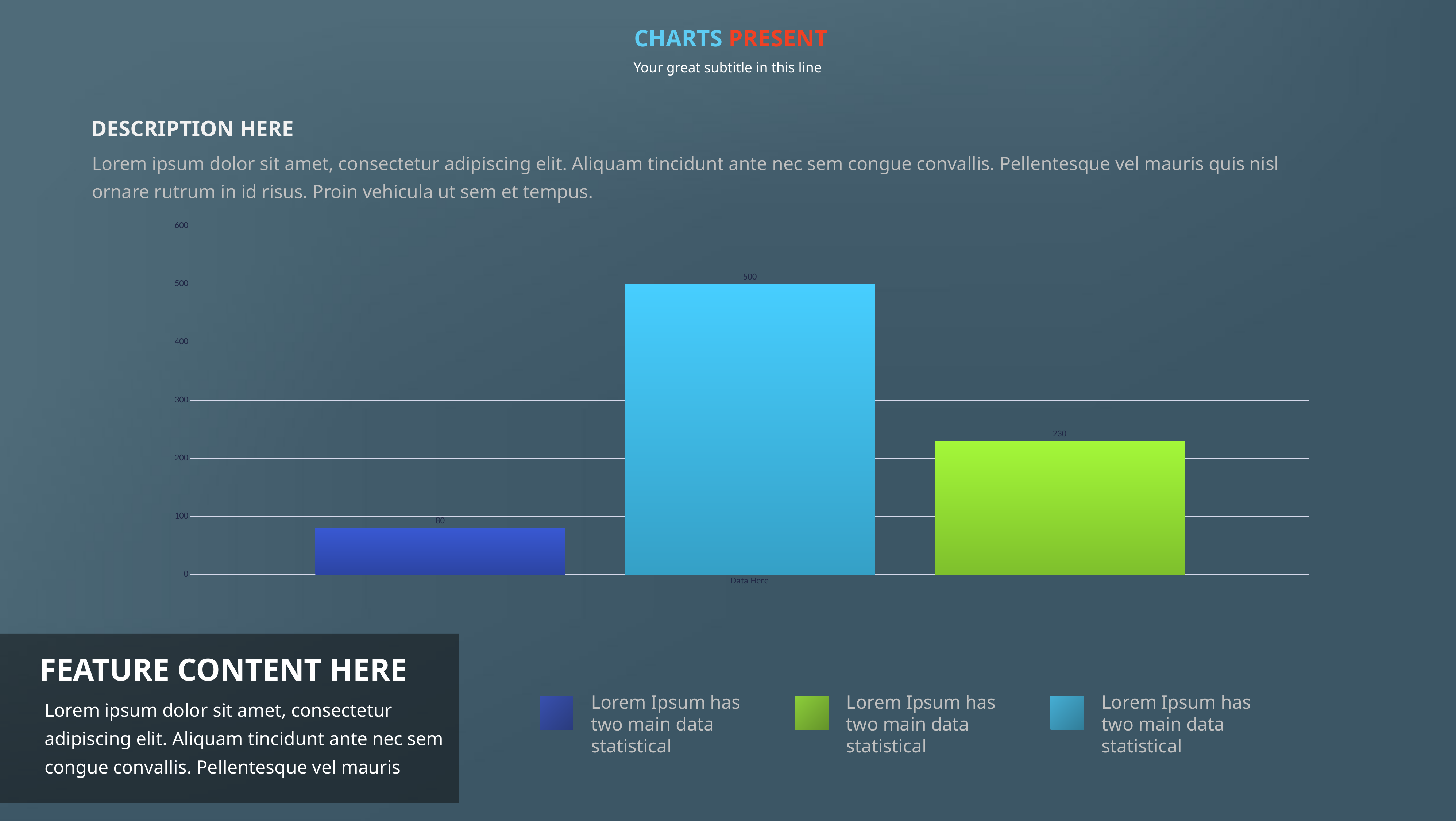
Which bar has the lowest value? The dark blue bar Which is larger, the green bar or the dark blue bar? The green bar What is the value of the dark blue bar? 80 What is the value of the green bar? 230 What is the category label shown on the x axis of the chart? Data Here Which bar has the highest value? The light blue (cyan) bar What is the difference between the green bar and the dark blue bar? 150 How many bars are plotted in the chart? 3 What is the value of the light blue (cyan) bar? 500 Is the value of the green bar greater or less than 300? less What is the difference between the light blue bar and the green bar? 270 What type of chart is shown on the slide? Bar chart